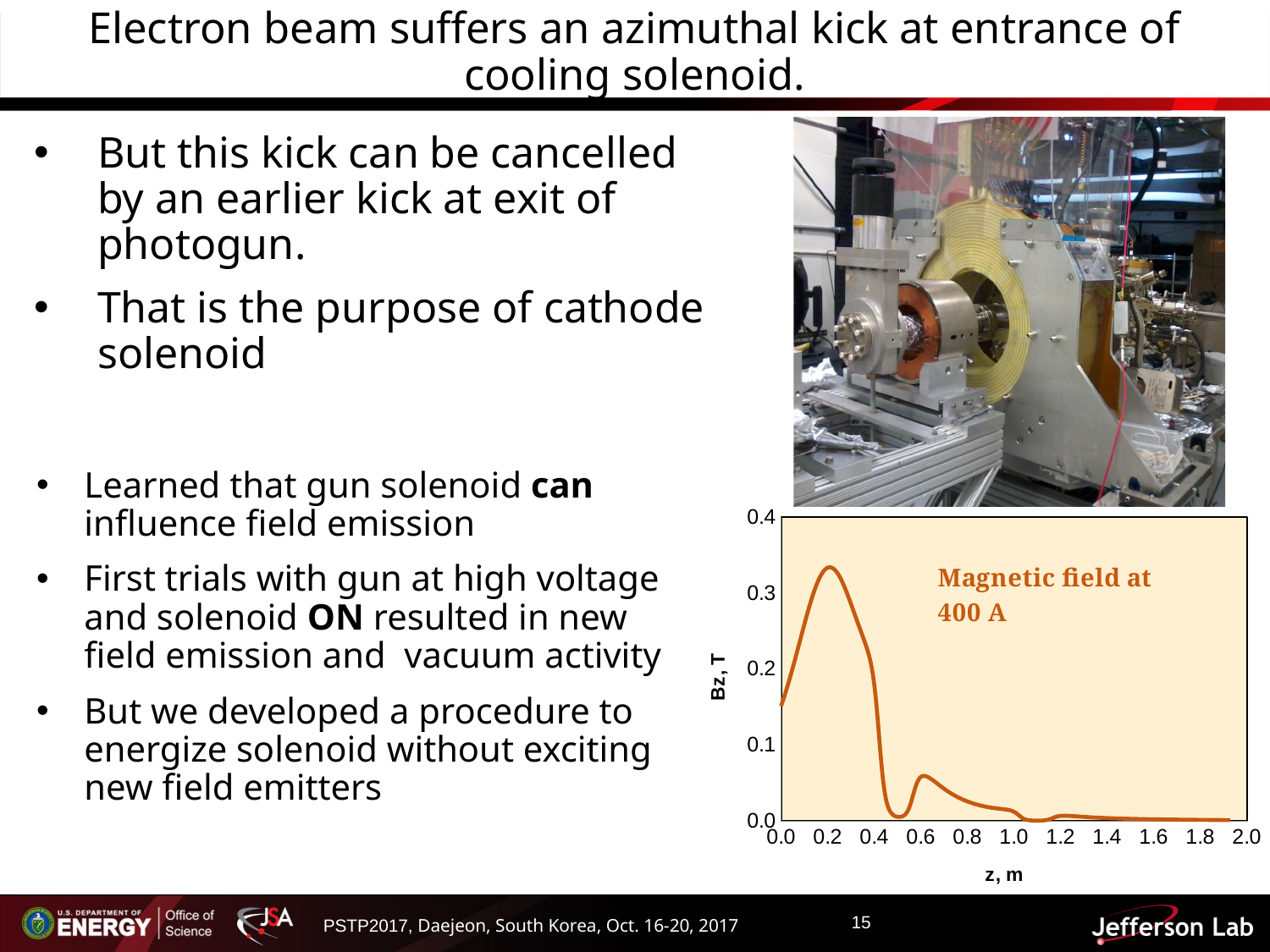
Does Bz rise or fall along the z axis between z = 0.2 m and z = 0.5 m? fall What is the label of the vertical axis of the chart? Bz, T Is the value of Bz at z = 0.4 m greater or less than 0.1? greater Does Bz rise or fall along the z axis between z = 0.0 m and z = 0.2 m? rise Is the value of Bz at z = 0.6 m greater or less than 0.1? less Is the value of Bz at z = 0.0 m greater or less than 0.2? less What kind of chart is shown at the bottom right of the slide? line chart How many lines (series) are plotted on the chart? 1 What is the highest tick value shown on the vertical axis of the chart? 0.4 What is the label of the horizontal axis of the chart? z, m